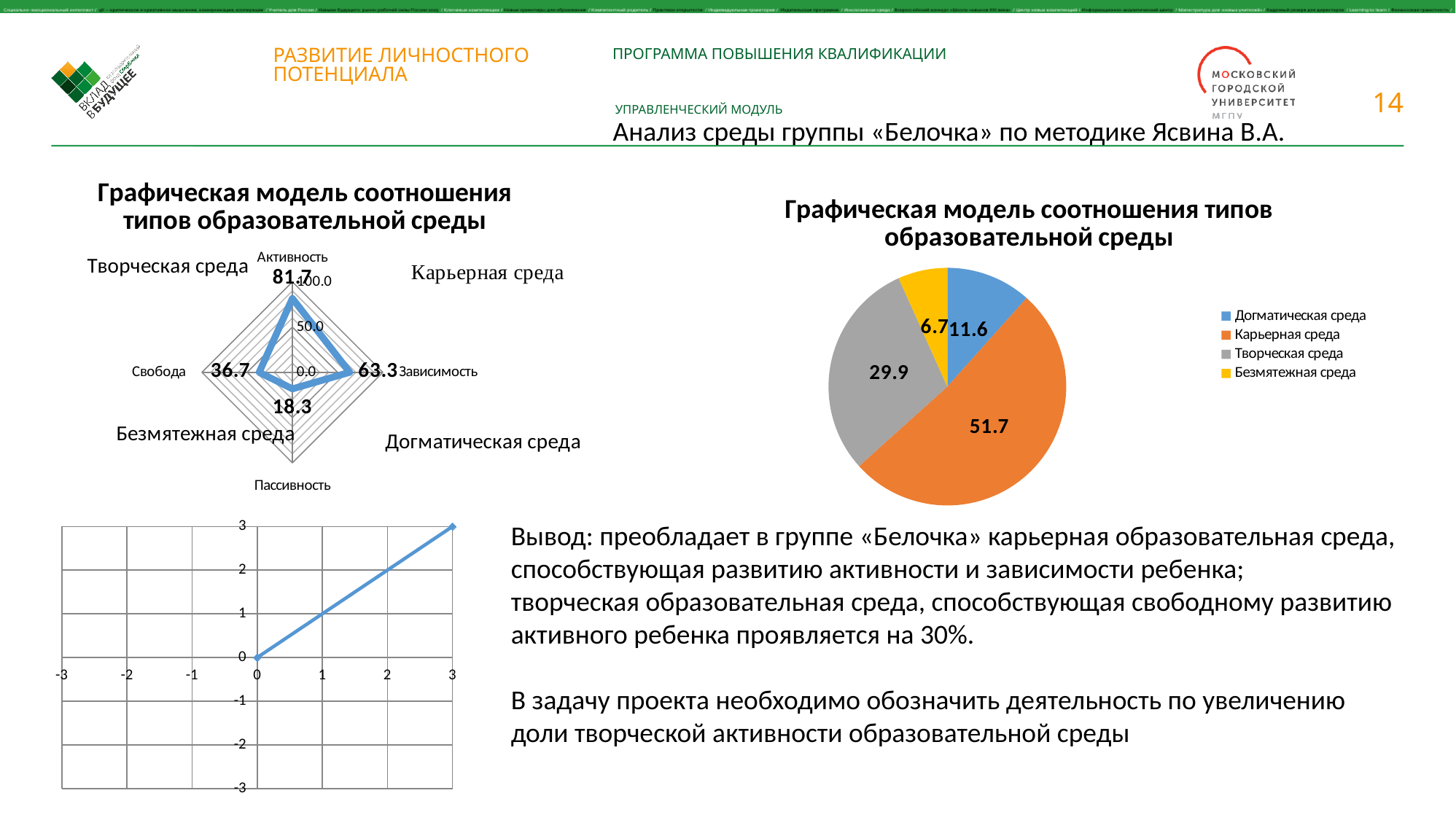
In the pie chart on the right, what is the value for Творческая среда? 29.9 In the pie chart on the right, which category has the smallest slice? Безмятежная среда In the pie chart on the right, what is the value for Карьерная среда? 51.7 In the radar chart on the left, which is larger: the value for Зависимость or the value for Свобода? Зависимость In the radar chart on the left, what is the value for Активность? 81.7 What kind of chart is shown at the bottom left of the slide? Line chart In the pie chart on the right, what is the difference between the values for Карьерная среда and Творческая среда? 21.8 In the pie chart on the right, what colour is the slice for Догматическая среда? Blue In the radar chart on the left, what is the value for Пассивность? 18.3 In the radar chart on the left, is the value for Зависимость greater or less than 50.0? greater In the pie chart on the right, which category has the largest slice? Карьерная среда How many entries does the legend of the pie chart on the right list? 4